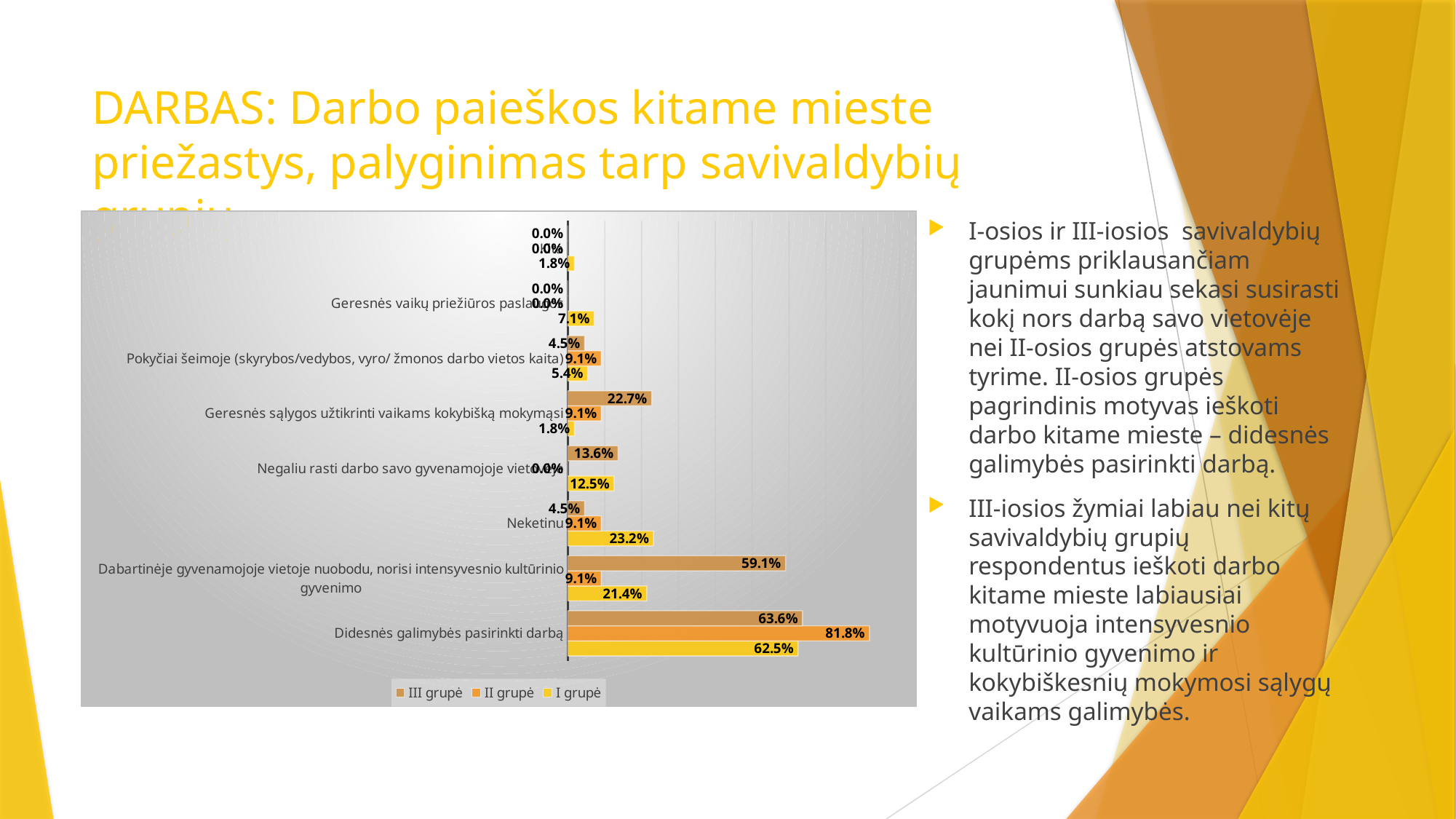
What is the value for II grupė in the category 'Didesnės galimybės pasirinkti darbą'? 81.8% What is the value for III grupė in the category 'Dabartinėje gyvenamojoje vietoje nuobodu, norisi intensyvesnio kultūrinio gyvenimo'? 59.1% What is the value for I grupė in the category 'Neketinu'? 23.2% Which series has the lowest value in the category 'Negaliu rasti darbo savo gyvenamojoje vietoje'? II grupė What kind of chart is shown on the slide? bar chart What is the value for I grupė in the category 'Geresnės vaikų priežiūros paslaugos'? 7.1% What is the difference between the II grupė and I grupė values in the category 'Didesnės galimybės pasirinkti darbą'? 19.3% Which is larger in the category 'Neketinu': the value for I grupė or the value for III grupė? I grupė Which series is shown in yellow in the chart legend? I grupė What is the value for III grupė in the category 'Geresnės sąlygos užtikrinti vaikams kokybišką mokymąsi'? 22.7% Which series has the highest value in the category 'Didesnės galimybės pasirinkti darbą'? II grupė How many series does the chart legend list? 3